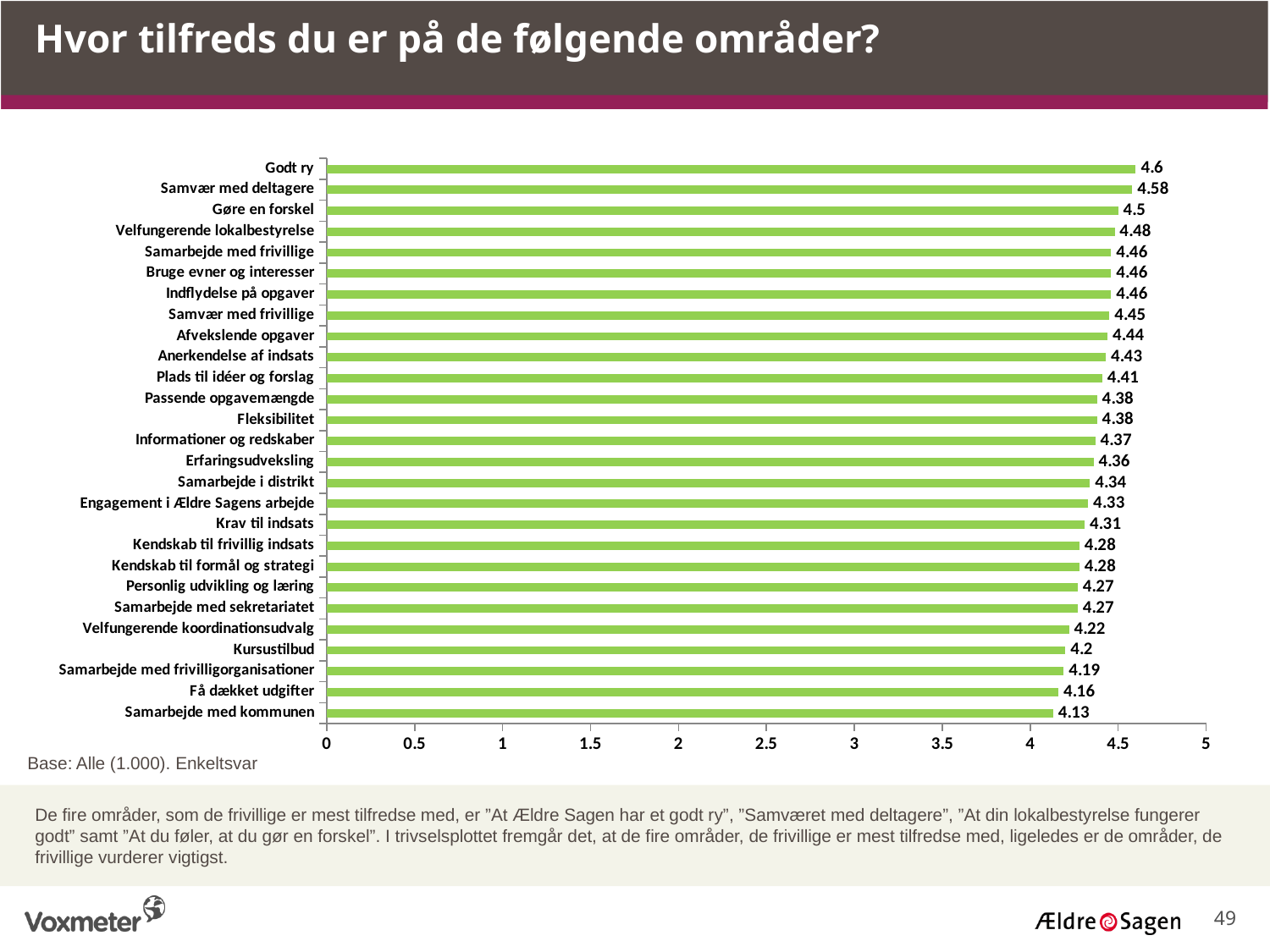
Which category has the lowest value? Samarbejde med kommunen Which category has the highest value? Godt ry Which is larger, the value for Gøre en forskel or the value for Erfaringsudveksling? Gøre en forskel What is the value for Fleksibilitet? 4.38 What is the value for Samarbejde med kommunen? 4.13 What is the title of the slide? Hvor tilfreds du er på de følgende områder? How many categories are shown in the chart? 27 What is the value for Kursustilbud? 4.2 What is the value for Godt ry? 4.6 What is the difference between the values for Godt ry and Samarbejde med kommunen? 0.47 Is the value for Få dækket udgifter greater or less than 4.5? less What kind of chart is shown on the slide? Bar chart